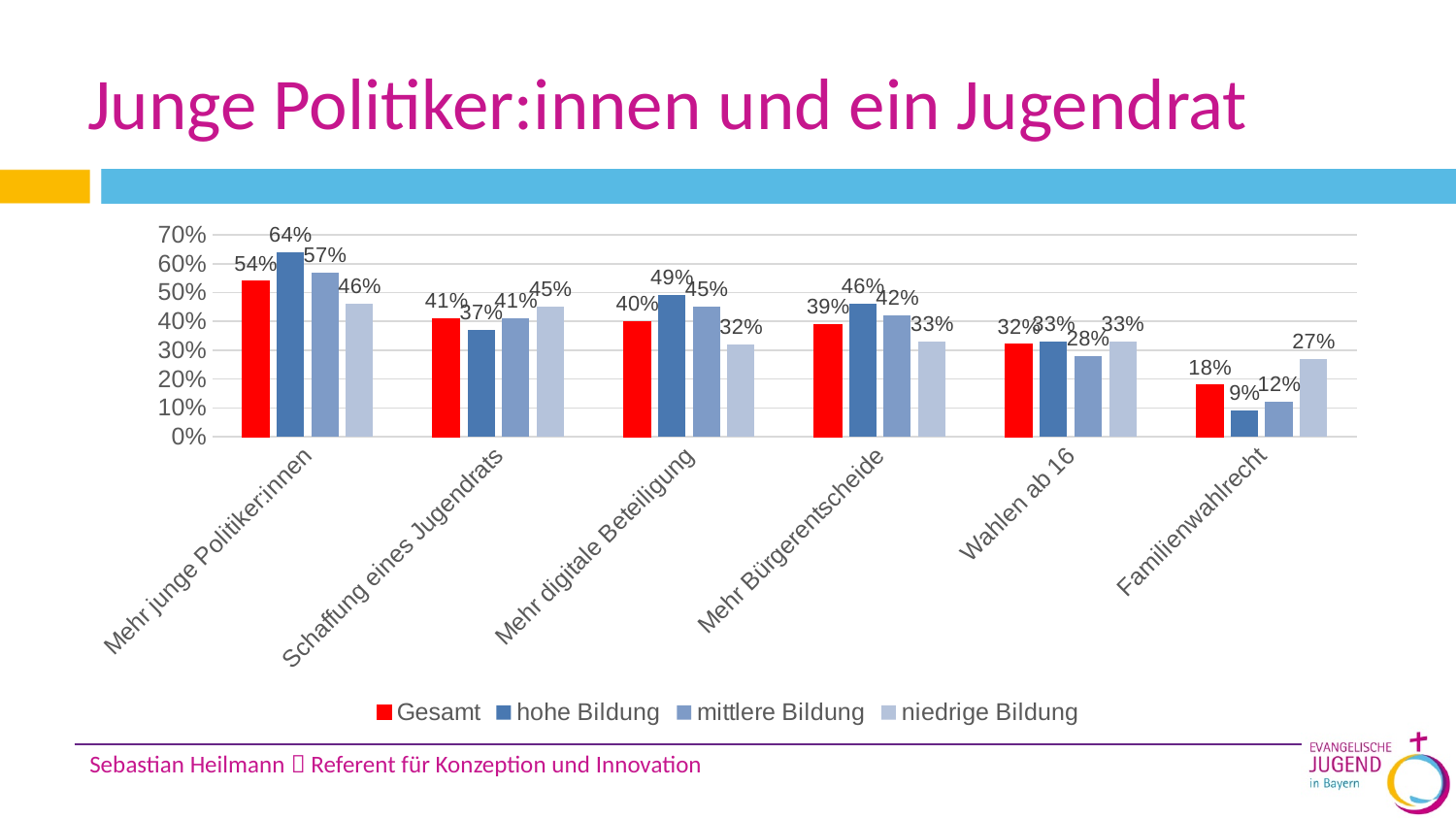
What is the Gesamt value for Familienwahlrecht? 18% Which category has the highest Gesamt value? Mehr junge Politiker:innen For Familienwahlrecht, which is larger: the value for niedrige Bildung or the value for hohe Bildung? niedrige Bildung Which series is shown in red? Gesamt How many series does the legend list? 4 How many categories are shown on the x axis? 6 Which category has the lowest value for hohe Bildung? Familienwahlrecht What is the value for mittlere Bildung in the category Wahlen ab 16? 28% What is the value for hohe Bildung in the category Mehr junge Politiker:innen? 64% What is the value for niedrige Bildung in the category Schaffung eines Jugendrats? 45% What kind of chart is shown on the slide? Bar chart What is the difference between the hohe Bildung and niedrige Bildung values for Mehr junge Politiker:innen? 18 percentage points